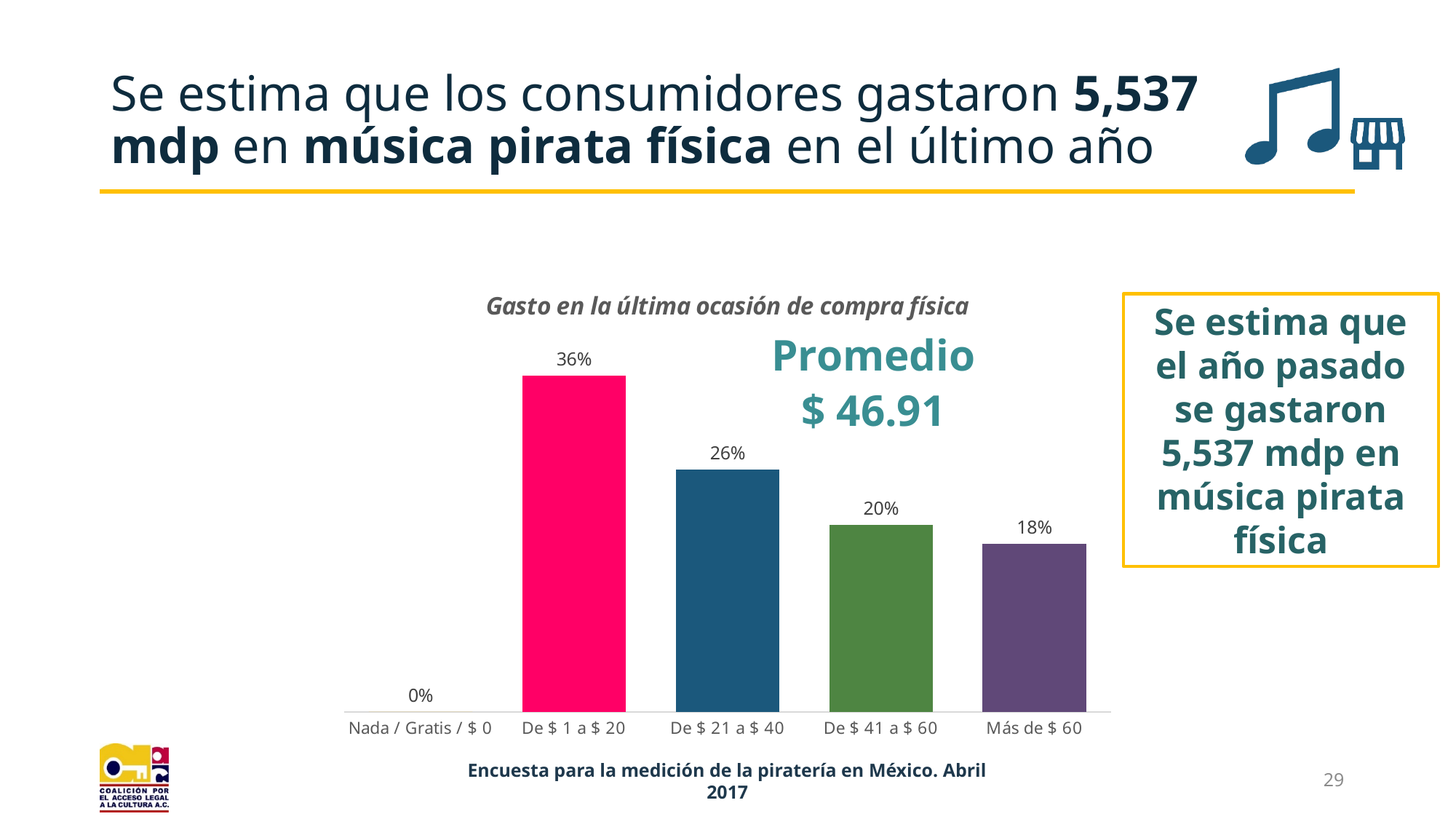
Do the values rise or fall from "De $ 1 a $ 20" to "Más de $ 60"? Fall Which category has the highest value? De $ 1 a $ 20 How many categories are shown on the x axis of the chart? 5 What is the value for the category "Más de $ 60"? 18% What is the value for the category "De $ 1 a $ 20"? 36% What kind of chart is shown on the slide? Bar chart What is the value for the category "Nada / Gratis / $ 0"? 0% Which is larger, the value for "De $ 41 a $ 60" or the value for "Más de $ 60"? De $ 41 a $ 60 Which category has the lowest value? Nada / Gratis / $ 0 What is the difference between the values for "De $ 1 a $ 20" and "De $ 21 a $ 40"? 10% What is the value for the category "De $ 21 a $ 40"? 26% What is the title of the chart? Gasto en la última ocasión de compra física